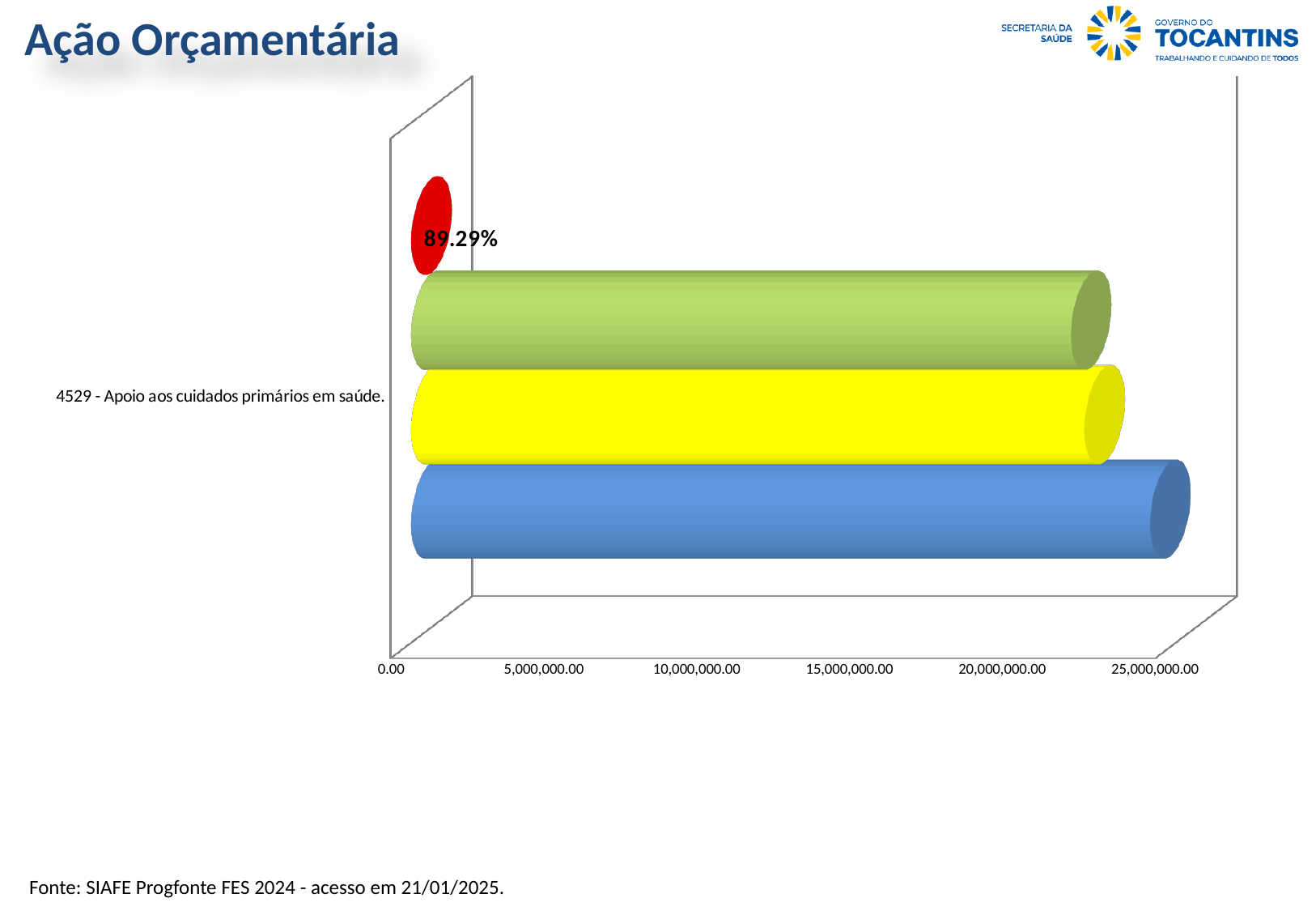
How many categories are shown on the vertical axis of the chart? 1 What is the highest tick value shown on the horizontal axis? 25,000,000.00 What kind of chart is shown on the slide? bar chart Which is larger, the blue bar or the green bar? blue bar What percentage value is printed as a data label on the chart? 89.29% Is the value of the yellow bar greater or less than 15,000,000.00? greater Is the value of the blue bar greater or less than 20,000,000.00? greater What is the category label shown on the chart? 4529 - Apoio aos cuidados primários em saúde. Is the value of the green bar greater or less than 25,000,000.00? less Which coloured bar is the longest in the chart? blue Which coloured bar is the shortest in the chart? red